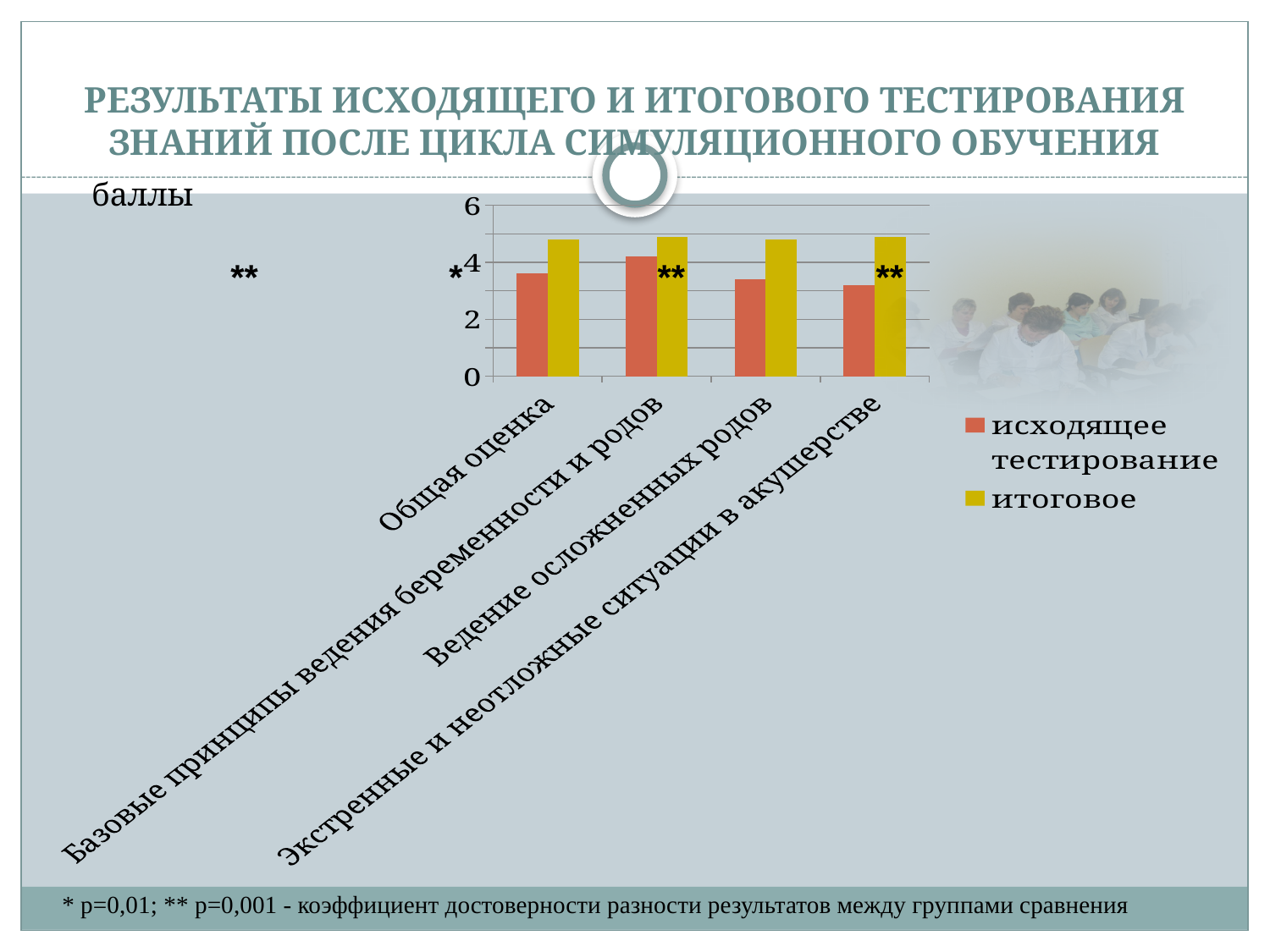
What unit label is shown above the vertical axis of the chart? баллы Is the value of исходящее тестирование for Ведение осложненных родов greater or less than 4? less How many series does the chart's legend list? 2 For Ведение осложненных родов, which is larger: исходящее тестирование or итоговое? итоговое How many categories are shown on the x axis of the chart? 4 What are the two series named in the chart's legend? исходящее тестирование; итоговое What kind of chart is shown on the slide? bar chart Is the value of исходящее тестирование for Экстренные и неотложные ситуации в акушерстве greater or less than 4? less Which category has the highest value for исходящее тестирование? Базовые принципы ведения беременности и родов Is the value of исходящее тестирование for Общая оценка greater or less than 4? less